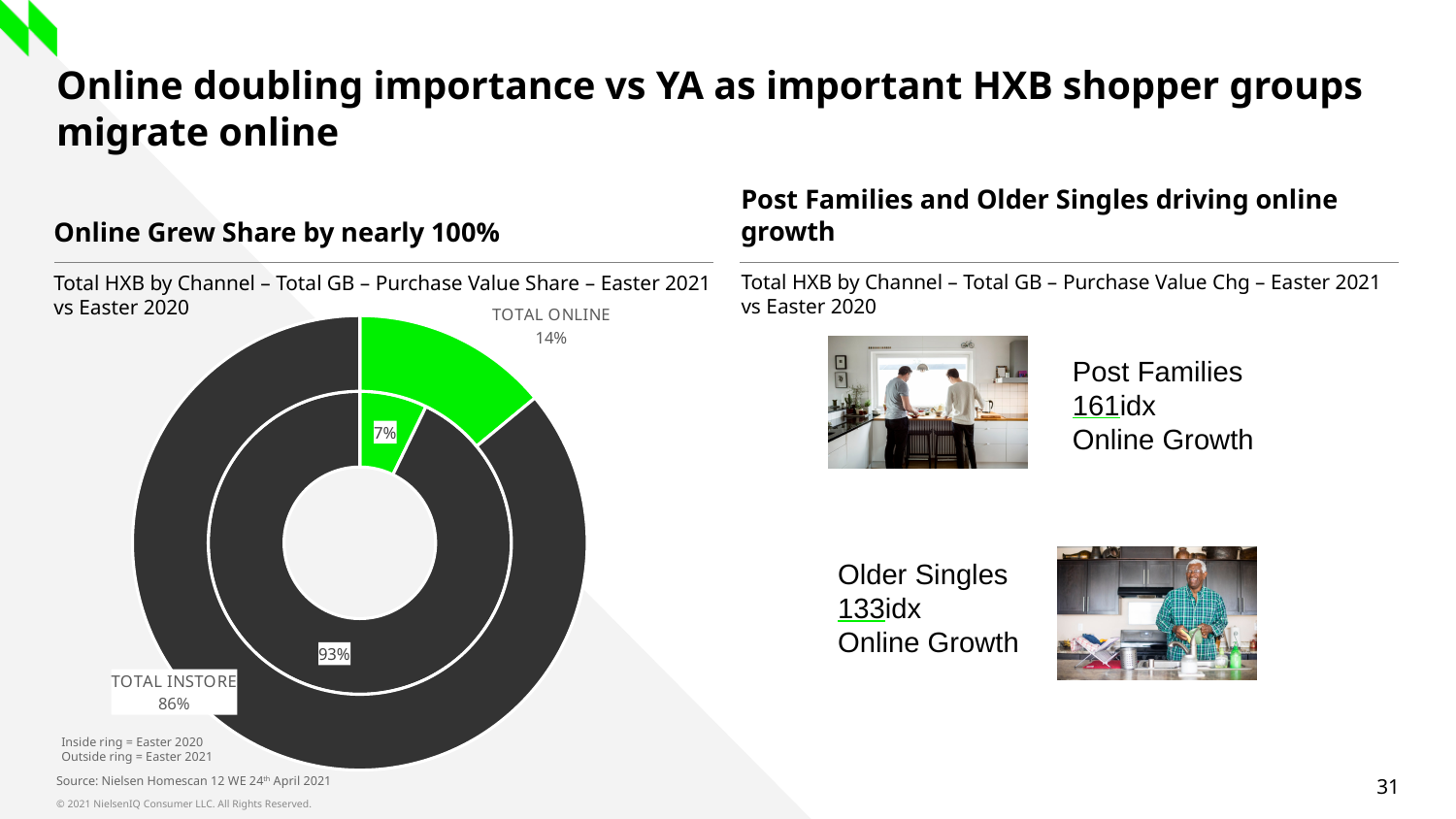
According to the note on the chart, which period does the inside ring represent? Easter 2020 What is the purchase value share for Total Instore in the inside ring (Easter 2020)? 93% Which channel has the largest share in the outside ring (Easter 2021)? Total Instore What is the purchase value share for Total Online in the inside ring (Easter 2020)? 7% What is the difference between the Total Instore and Total Online shares in the outside ring (Easter 2021)? 72 percentage points By how many percentage points did the Total Online share change from the inside ring (Easter 2020) to the outside ring (Easter 2021)? 7 percentage points What kind of chart is shown on the slide? Doughnut chart What is the purchase value share for Total Instore in the outside ring (Easter 2021)? 86% How many channel categories does the doughnut chart show? 2 Is the Total Online share larger in the inside ring (Easter 2020) or the outside ring (Easter 2021)? Outside ring (Easter 2021) What is the purchase value share for Total Online in the outside ring (Easter 2021)? 14% Which channel has the smallest share in the inside ring (Easter 2020)? Total Online